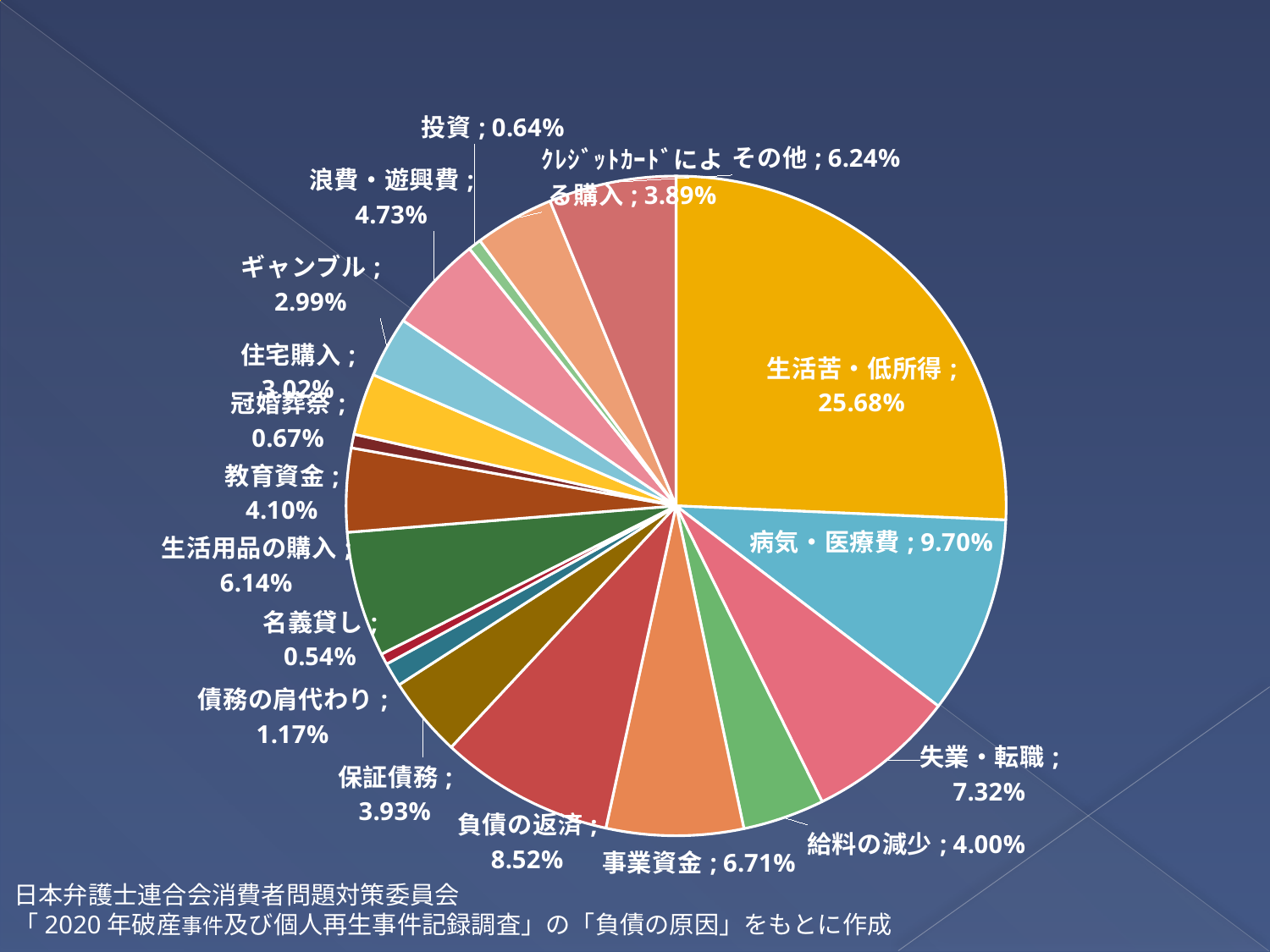
What is the difference in percentage points between 給料の減少 and 保証債務? 0.07 Which is larger, the share for 浪費・遊興費 or the share for 教育資金? 浪費・遊興費 Which category has the largest share of the pie? 生活苦・低所得 What kind of chart is shown on the slide? pie chart What percentage is shown for 病気・医療費? 9.70% Which category has the smallest share of the pie? 名義貸し What percentage is shown for 負債の返済? 8.52% Which is larger, the share for 失業・転職 or the share for 事業資金? 失業・転職 What percentage is shown for 生活苦・低所得? 25.68% How many categories (slices) does the pie chart have? 18 What percentage is shown for クレジットカードによる購入? 3.89% What is the difference in percentage points between 生活苦・低所得 and 病気・医療費? 15.98